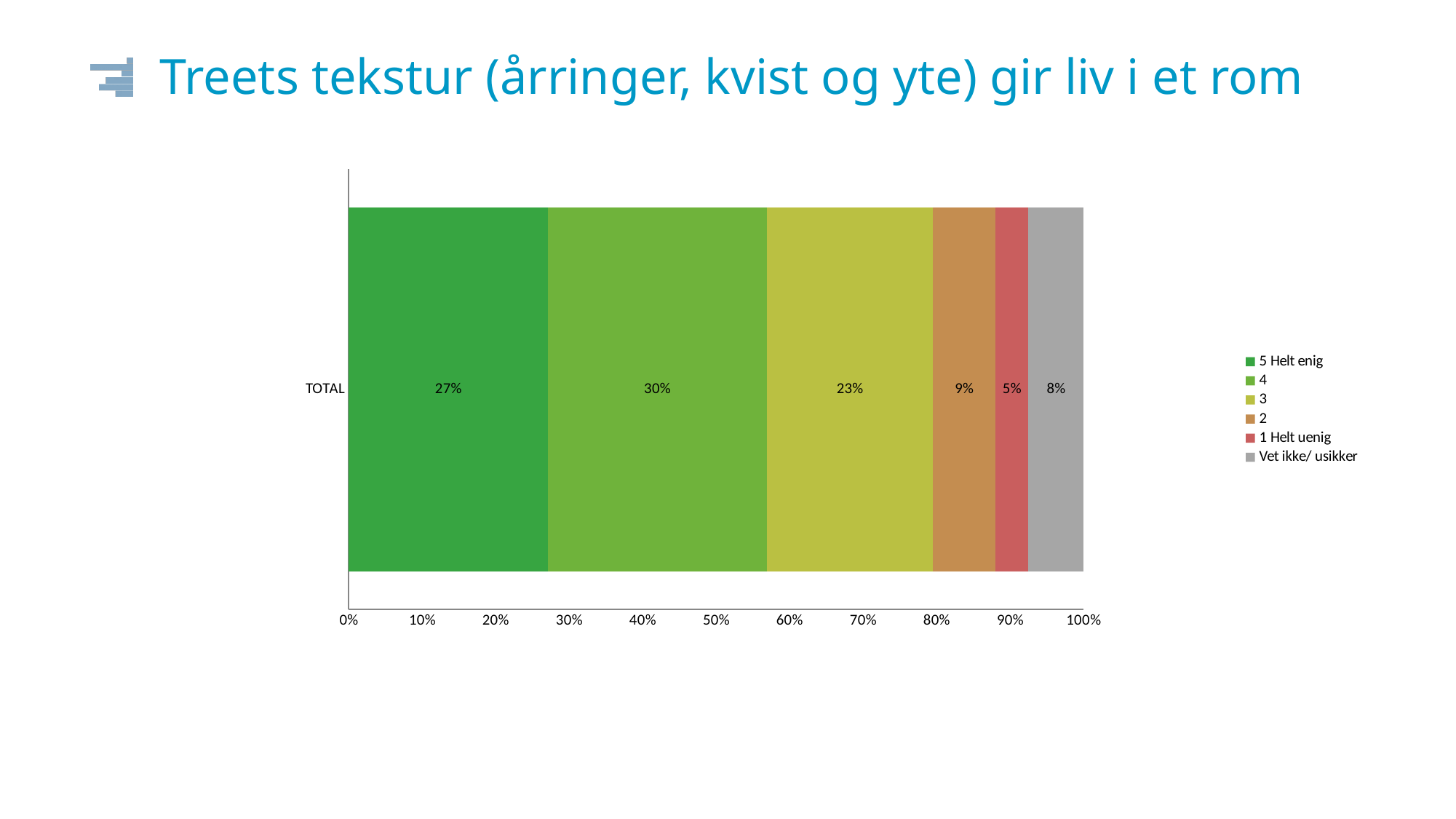
What percentage of respondents answered "4"? 30% What is the combined percentage of the "5 Helt enig" and "4" segments? 57% What is the difference in percentage points between the "4" and "5 Helt enig" segments? 3 What percentage of respondents answered "Vet ikke/ usikker"? 8% What percentage of respondents answered "1 Helt uenig"? 5% What percentage of respondents answered "5 Helt enig"? 27% How many series does the legend list? 6 Which response category has the largest share of the TOTAL bar? 4 What percentage of respondents answered "3"? 23% What kind of chart is shown on the slide? Stacked bar chart Which is larger, the share for "2" or the share for "Vet ikke/ usikker"? 2 Which response category has the smallest share of the TOTAL bar? 1 Helt uenig